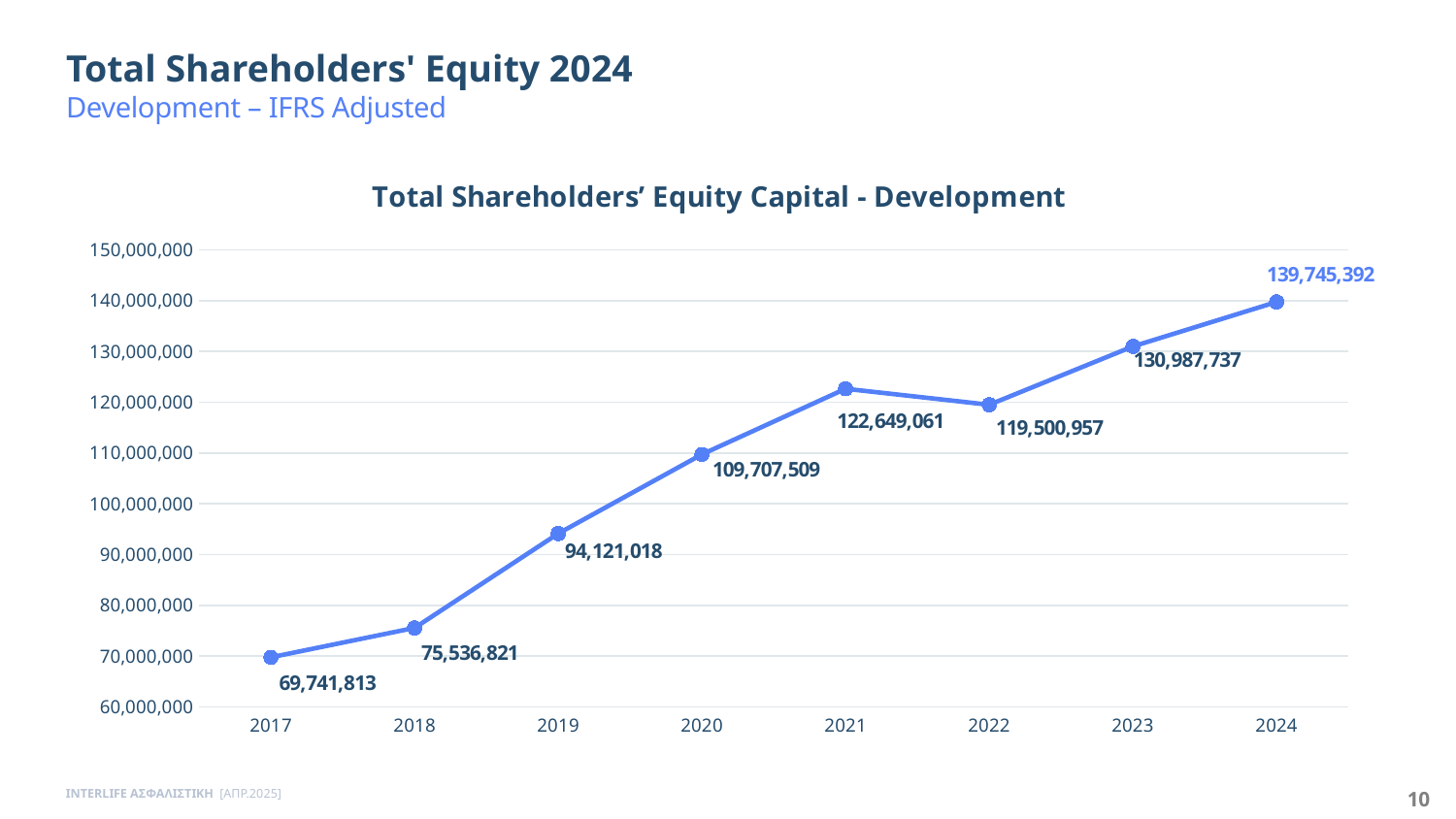
What is the title of the chart? Total Shareholders’ Equity Capital - Development Which is larger, the value for 2021 or the value for 2022? 2021 Which year has the lowest value? 2017 Which year has the highest value? 2024 What is the difference between the values for 2024 and 2023? 8,757,655 What is the value for 2024? 139,745,392 How many years are plotted on the chart? 8 What is the value for 2017? 69,741,813 Is the value for 2019 greater or less than 90,000,000? greater What is the value for 2021? 122,649,061 By how much did the value fall from 2021 to 2022? 3,148,104 What kind of chart is shown? line chart